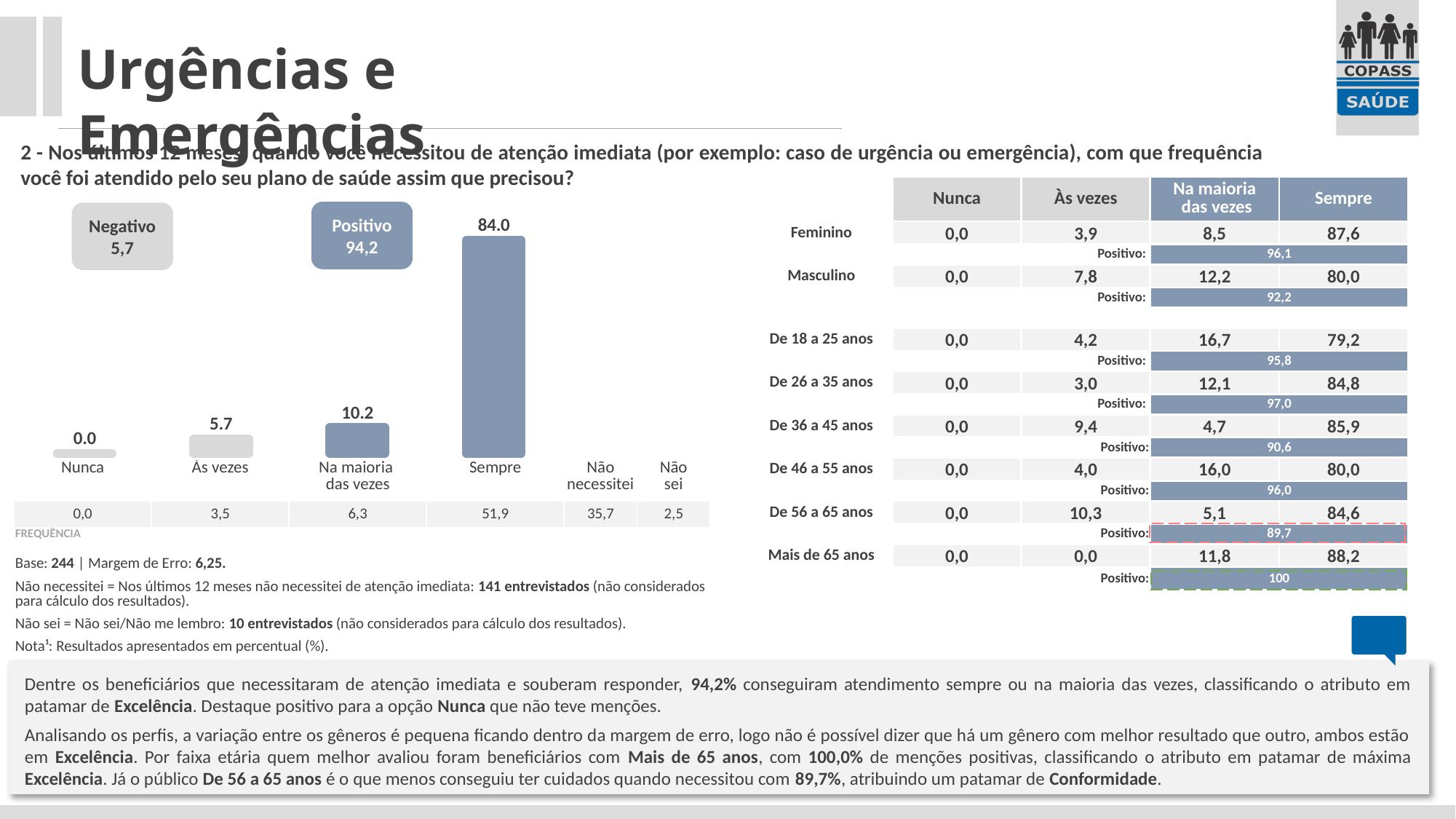
In the bar chart, what is the value for "Às vezes"? 5.7 In the bar chart, what is the difference between the values for "Sempre" and "Na maioria das vezes"? 73.8 In the bar chart, what is the value for "Na maioria das vezes"? 10.2 In the bar chart, what is the combined value of "Às vezes" and "Na maioria das vezes"? 15.9 In the bar chart, which category has the lowest value? Nunca In the bar chart, which is larger: the value for "Às vezes" or for "Na maioria das vezes"? Na maioria das vezes In the FREQUÊNCIA row below the bar chart, what is the value for "Sempre"? 51,9 In the bar chart, what is the value for "Sempre"? 84.0 What value is shown in the "Positivo" box above the bar chart? 94,2 What kind of chart is shown on the left of the slide? Bar chart In the bar chart, what is the value for "Nunca"? 0.0 In the bar chart, which category has the highest value? Sempre